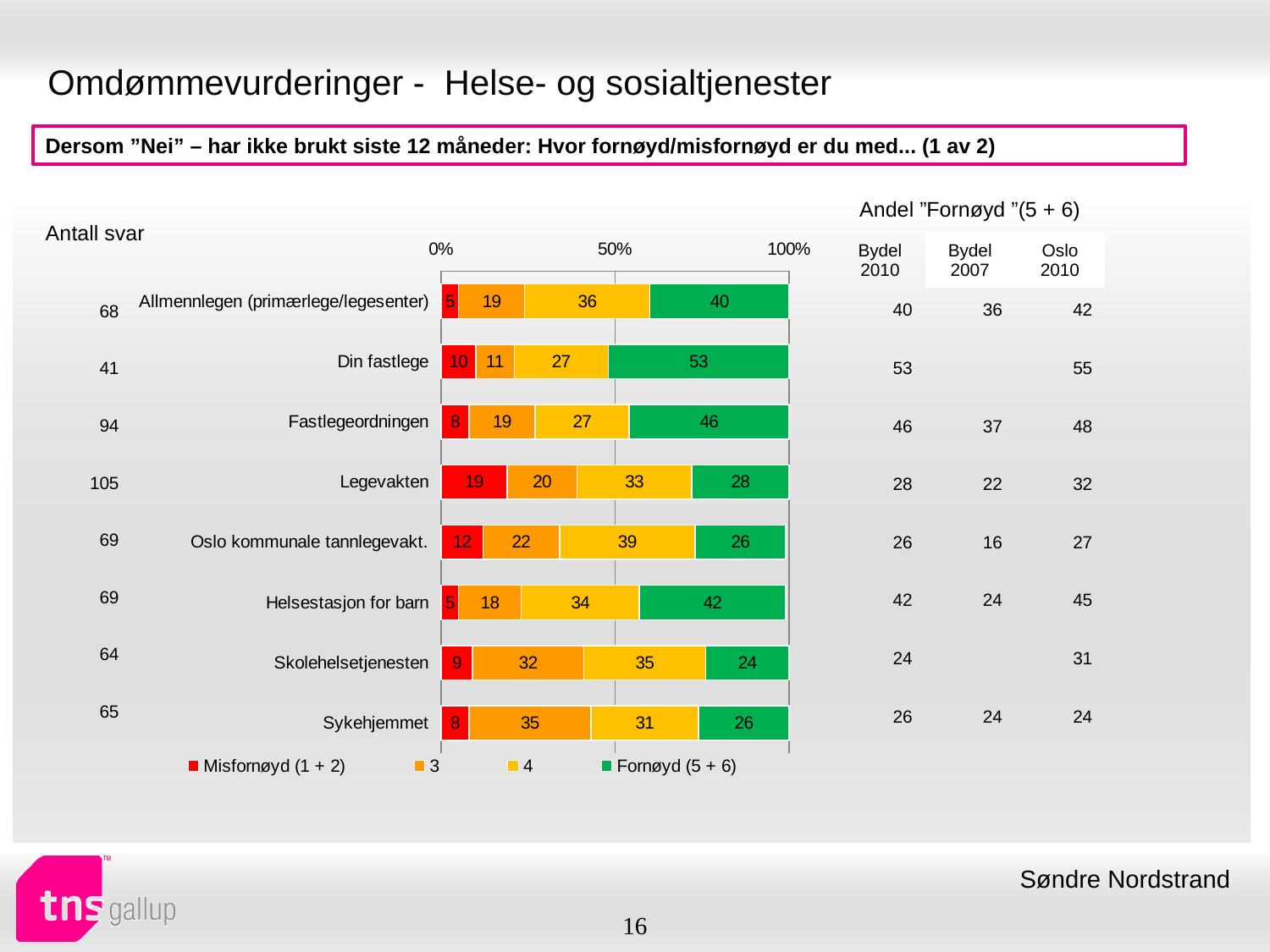
What is the "Misfornøyd (1 + 2)" value for Legevakten? 19 How many series does the legend list? 4 How many categories are shown in the chart? 8 What is the "Fornøyd (5 + 6)" value for Din fastlege? 53 What is the value of series "3" for Sykehjemmet? 35 What is the total of the stacked bar for Skolehelsetjenesten? 100 What kind of chart is shown on the slide? Stacked bar chart Which category has the lowest "Fornøyd (5 + 6)" value? Skolehelsetjenesten What is the difference between the "Fornøyd (5 + 6)" values for Fastlegeordningen and Legevakten? 18 Which has a larger "Misfornøyd (1 + 2)" value, Din fastlege or Helsestasjon for barn? Din fastlege Which category has the highest "Fornøyd (5 + 6)" value? Din fastlege What is the value of series "4" for Oslo kommunale tannlegevakt.? 39